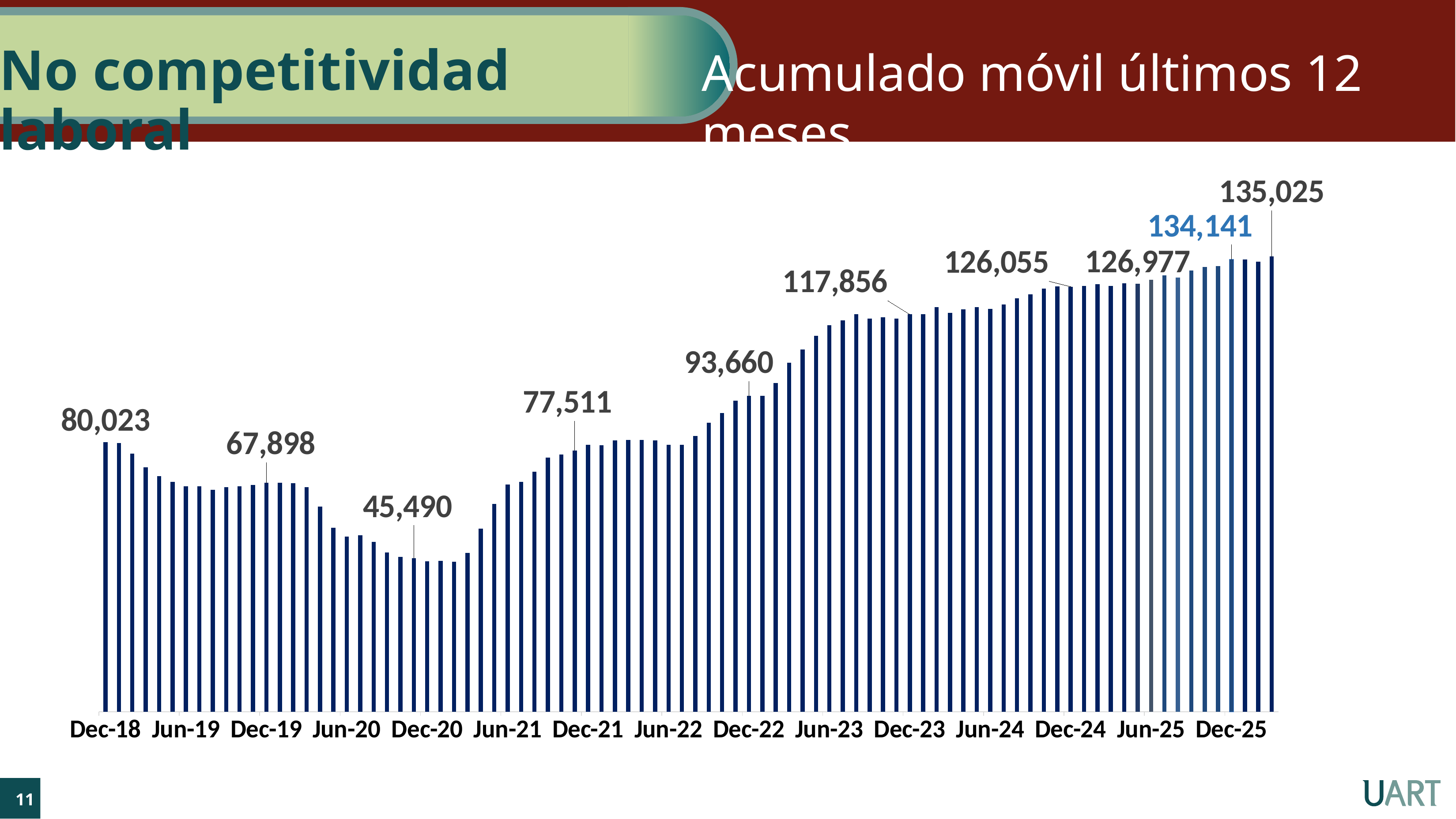
Which of the labelled values is the highest? 135,025 What is the value labelled for Dec-22? 93,660 Do the values generally rise or fall from Dec-20 to Dec-25? rise What is the difference between the Dec-21 value (77,511) and the Dec-20 value (45,490)? 32,021 What is the value labelled for Dec-18? 80,023 What is the difference between the Dec-24 value (126,055) and the Dec-23 value (117,856)? 8,199 Which is larger, the value for Dec-19 or the value for Dec-22? Dec-22 What kind of chart is shown on the slide? bar chart Which of the labelled values is the lowest? 45,490 What is the value labelled for Dec-23? 117,856 What is the value labelled on the last (rightmost) bar of the chart? 135,025